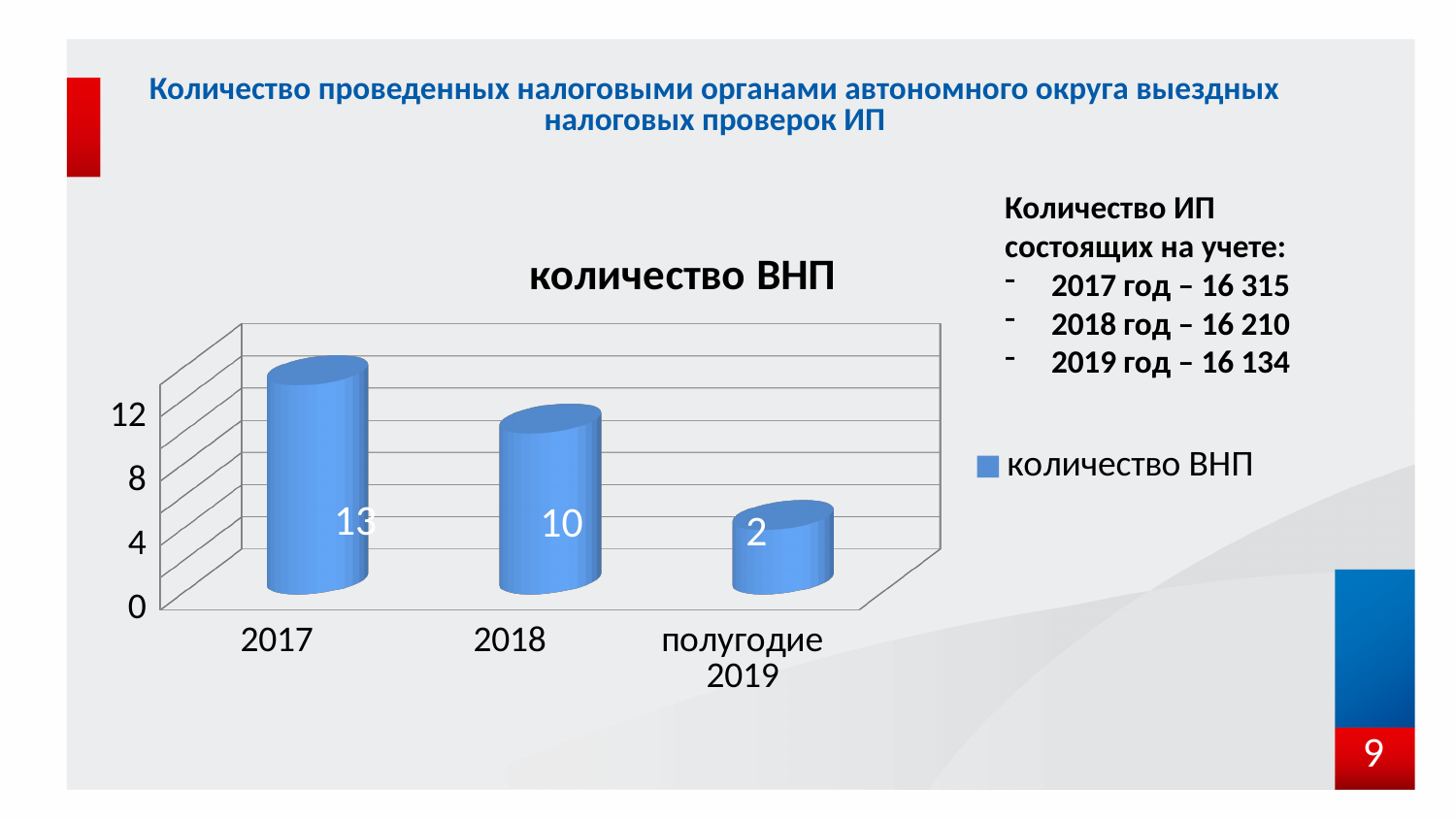
What is the value for 2017? 13 Is the value for 2018 greater or less than 8? greater What kind of chart is shown? bar chart Which category has the highest value? 2017 What is the difference between the values for 2017 and 2018? 3 What is the value for полугодие 2019? 2 Do the values rise or fall from 2017 to полугодие 2019? fall Which is larger, the value for 2017 or the value for 2018? 2017 Which category has the lowest value? полугодие 2019 What is the value for 2018? 10 How many categories are shown on the x axis? 3 What is the difference between the values for 2018 and полугодие 2019? 8